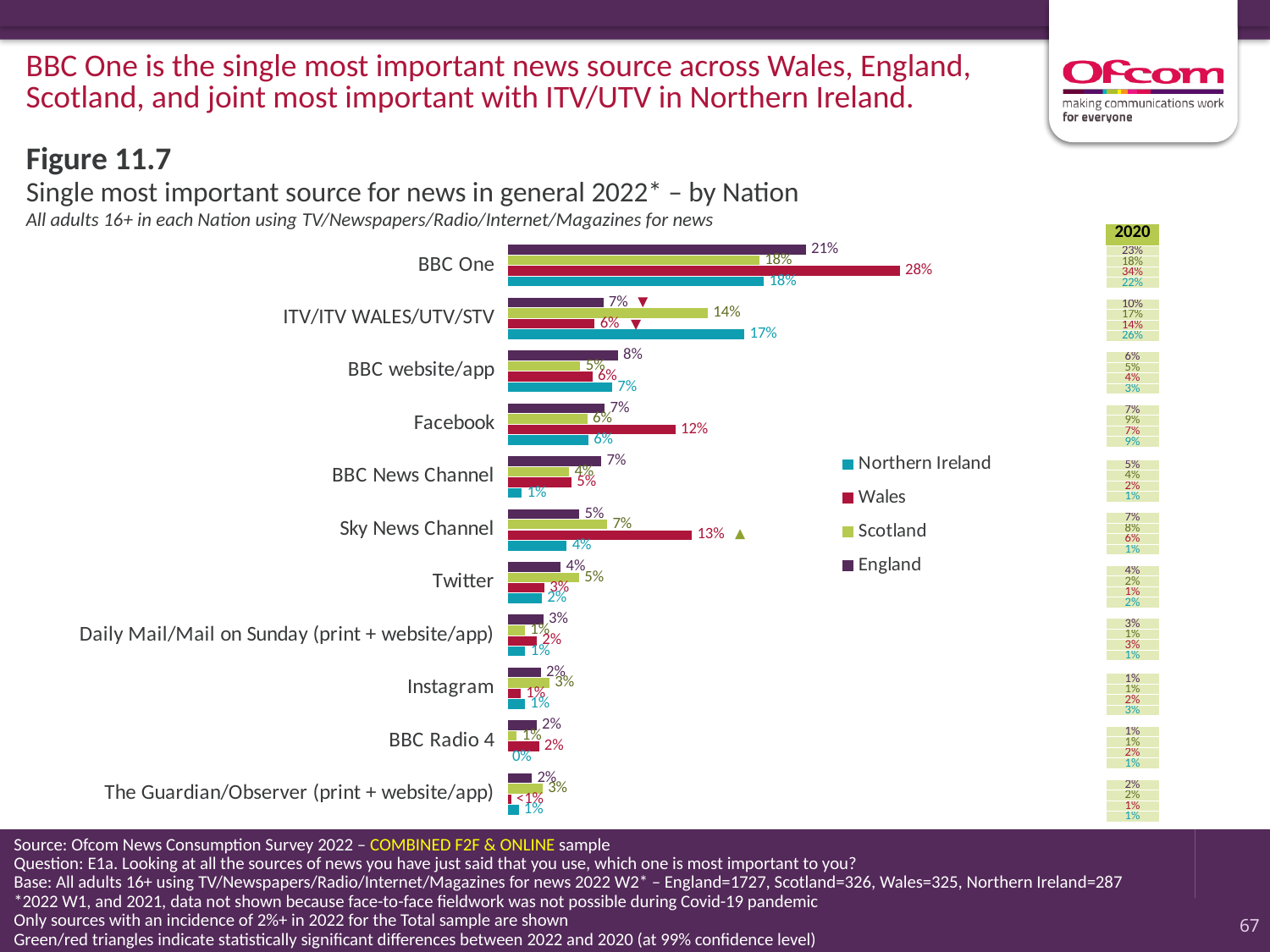
What is the value for Wales for Sky News Channel? 13% What is the value for England for BBC website/app? 8% What is the value for Wales for BBC One? 28% What is the value for Northern Ireland for ITV/ITV WALES/UTV/STV? 17% Which nation has the highest value for Facebook? Wales What is the difference between the Wales and England values for BBC One? 7% Which is larger for ITV/ITV WALES/UTV/STV: the Scotland value or the England value? Scotland Which nation is listed first in the legend? Northern Ireland How many series does the legend list? 4 Which nation has the lowest value for BBC News Channel? Northern Ireland What type of chart is shown on the slide? Bar chart How many news sources (categories) are plotted on the chart? 11